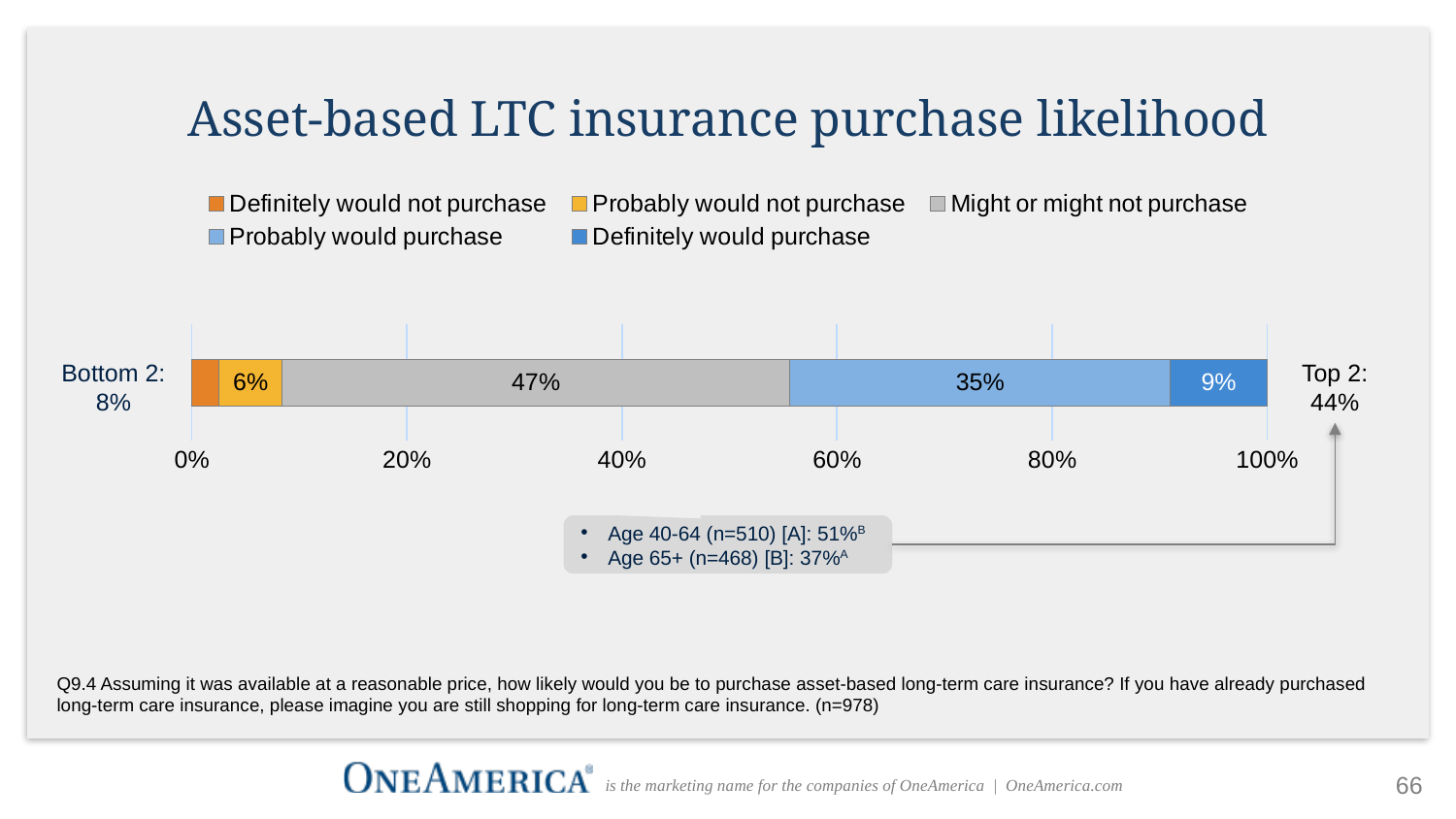
What percentage of respondents said they probably would purchase? 35% What Bottom 2 percentage is shown to the left of the bar? 8% What is the difference in percentage points between 'Might or might not purchase' and 'Probably would purchase'? 12 percentage points Which response category has the smallest share of the bar? Definitely would not purchase What percentage of respondents said they definitely would purchase? 9% What kind of chart is shown on the slide? Stacked bar chart How many response categories does the legend list? 5 What percentage of respondents said they might or might not purchase asset-based LTC insurance? 47% Which response category has the largest share of the bar? Might or might not purchase What percentage of respondents said they probably would not purchase? 6% Which is larger: the share for 'Definitely would purchase' or for 'Probably would not purchase'? Definitely would purchase What is the combined Top 2 share (Probably would purchase plus Definitely would purchase)? 44%